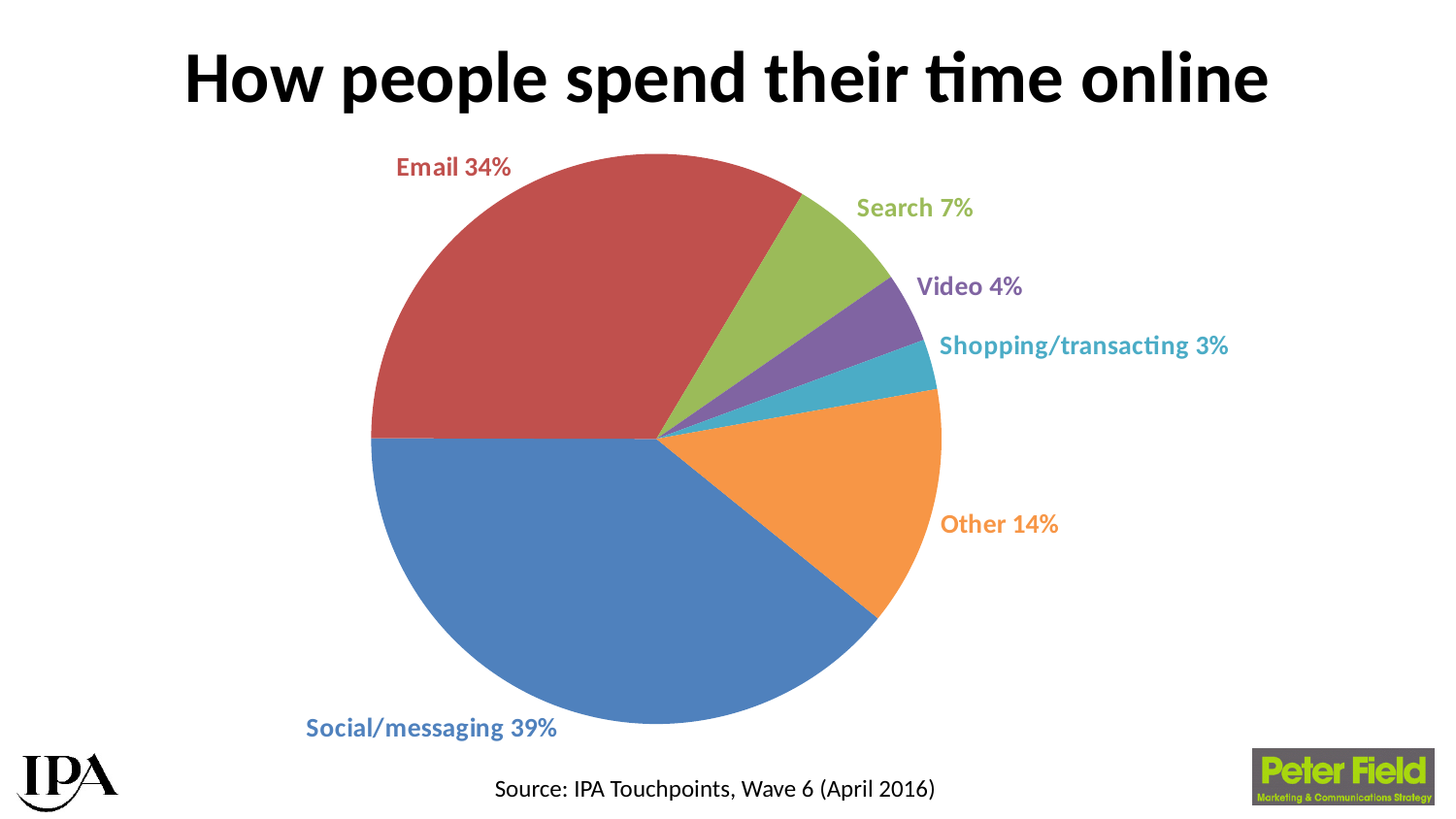
How many categories are shown in the pie chart? 6 Which category accounts for the largest share of time online? Social/messaging What is the title of the chart? How people spend their time online What is the difference in percentage points between Other and Search? 7 What share of time online is spent on Email? 34% Which is larger, the share for Search or the share for Video? Search What kind of chart is shown on the slide? Pie chart What is the difference in percentage points between Social/messaging and Email? 5 What share of time online is spent on Shopping/transacting? 3% What share of time online is spent on Social/messaging? 39% Which category accounts for the smallest share of time online? Shopping/transacting What share of time online is spent on Video? 4%